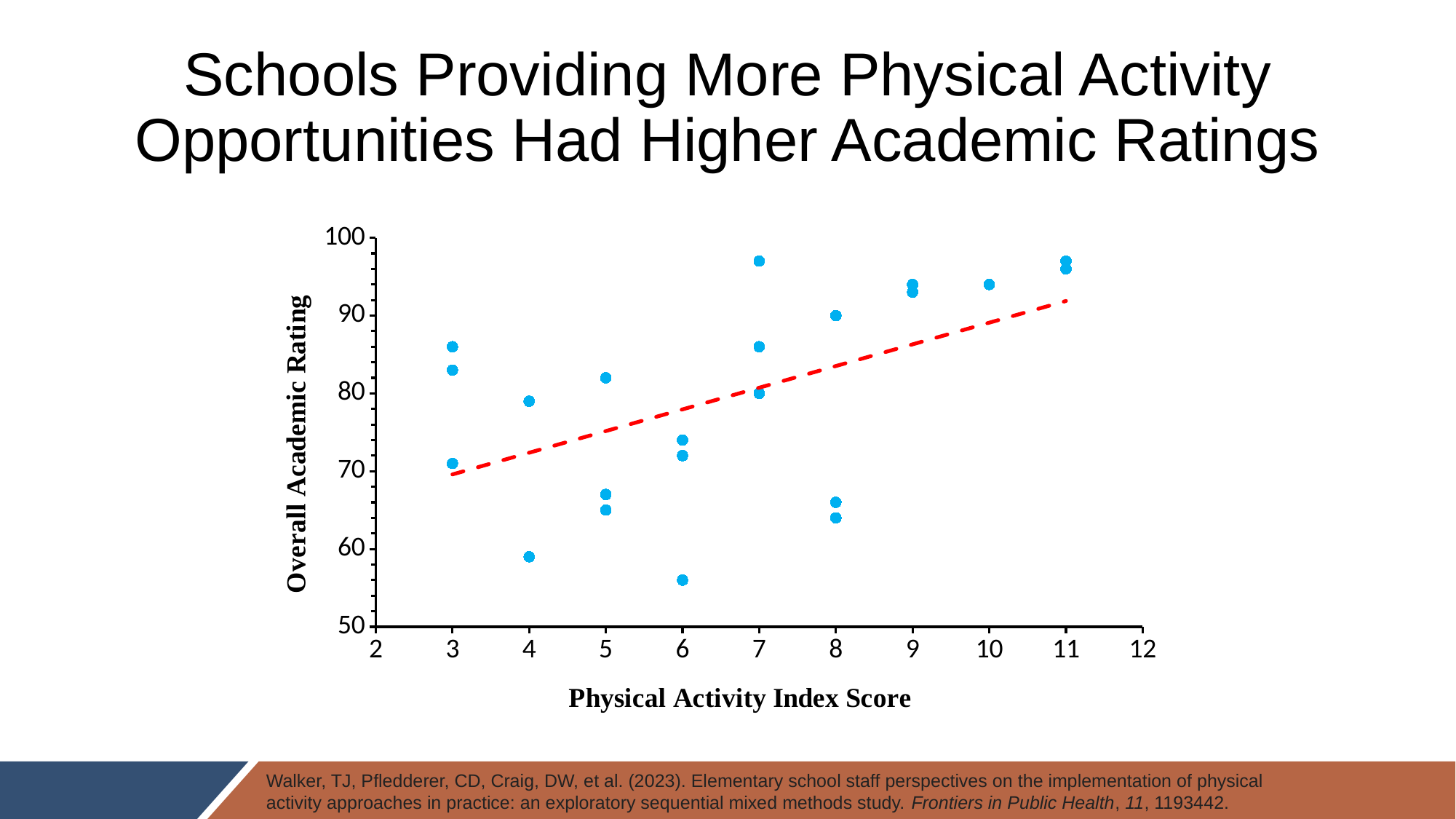
How many distinct Physical Activity Index Score values have points plotted on the chart? 9 Is the point plotted at a Physical Activity Index Score of 10 greater or less than 90? greater What is the label of the y axis? Overall Academic Rating What is the label of the x axis? Physical Activity Index Score What kind of chart is shown on the slide? Scatter plot Does the dashed trend line rise or fall as the Physical Activity Index Score increases? Rises Is the highest point plotted at a Physical Activity Index Score of 7 greater or less than 90? greater Is the lowest point plotted at a Physical Activity Index Score of 8 greater or less than 70? less What is the lowest Physical Activity Index Score at which any point is plotted? 3 What is the highest Physical Activity Index Score at which any point is plotted? 11